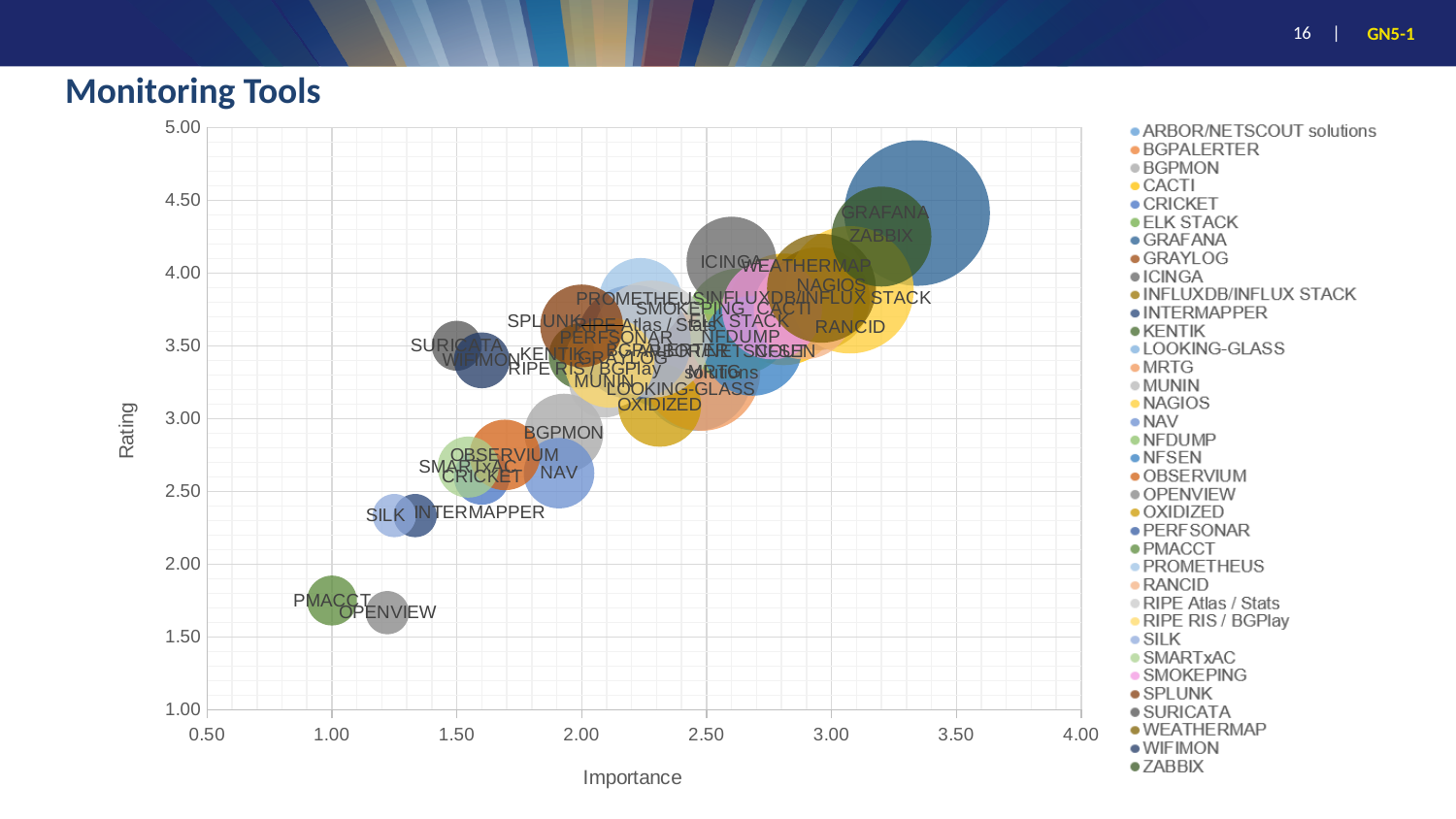
Which tool has the lowest Importance value? PMACCT Which has the higher Importance, SILK or ZABBIX? ZABBIX How many tools does the legend list? 36 Is the Rating value for PMACCT greater or less than 2.00? less Is the Rating value for GRAFANA greater or less than 4.00? greater What kind of chart is shown on the slide? Bubble chart Which has the higher Rating, PMACCT or GRAFANA? GRAFANA What are the x-axis and y-axis titles of the chart? Importance (x) and Rating (y) Is the Rating value for INTERMAPPER greater or less than 2.50? less What is the title of the chart? Monitoring Tools